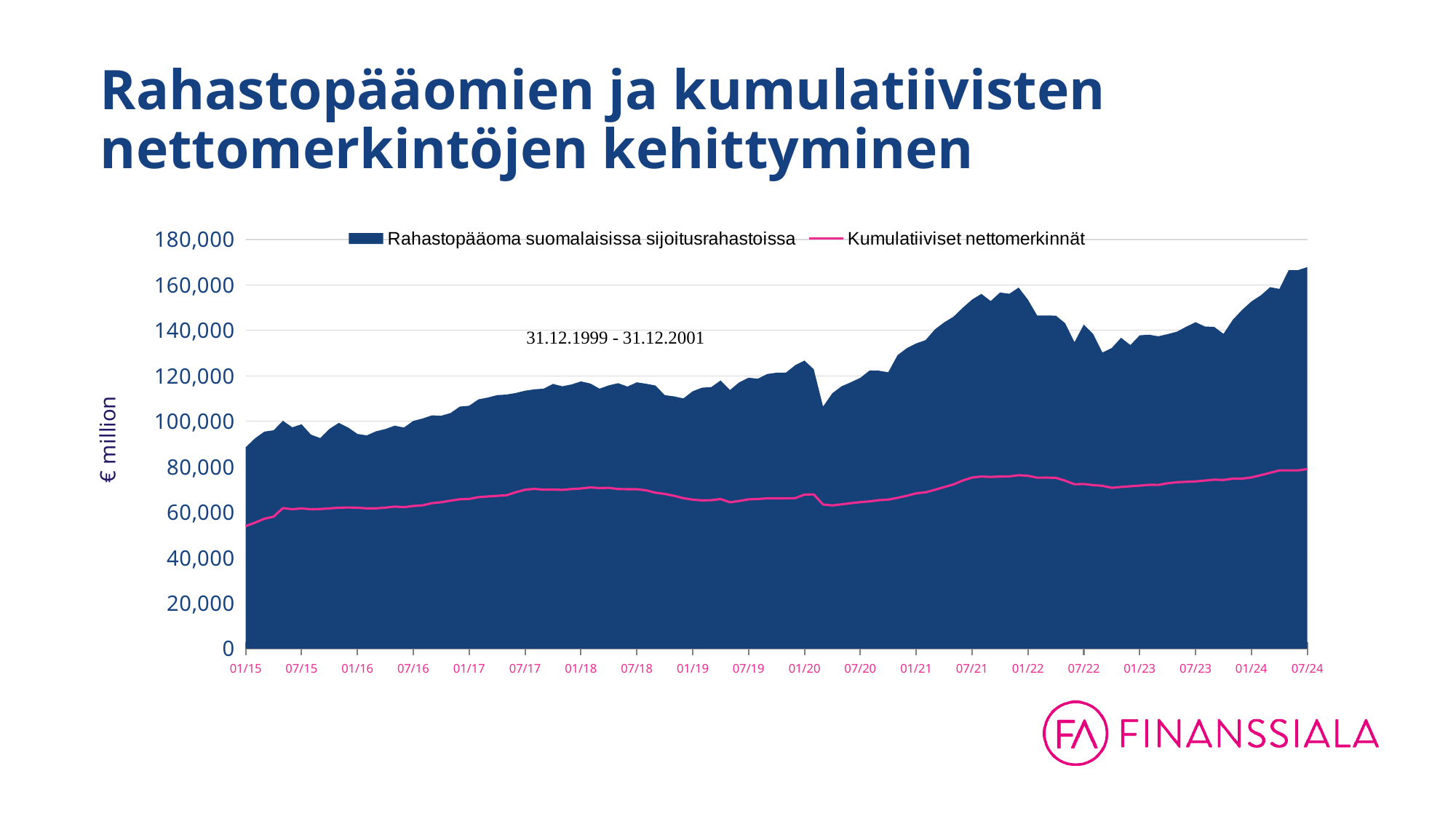
Is the value of Kumulatiiviset nettomerkinnät at 01/15 greater or less than 60,000? less What is the label on the vertical axis? € million At 07/24, which series has the higher value, Rahastopääoma suomalaisissa sijoitusrahastoissa or Kumulatiiviset nettomerkinnät? Rahastopääoma suomalaisissa sijoitusrahastoissa Is the value of Rahastopääoma suomalaisissa sijoitusrahastoissa at 07/21 greater or less than 140,000? greater Overall, does Kumulatiiviset nettomerkinnät rise or fall from 01/15 to 07/24? rise Is the value of Kumulatiiviset nettomerkinnät at 07/24 greater or less than 60,000? greater What are the two series named in the legend? Rahastopääoma suomalaisissa sijoitusrahastoissa; Kumulatiiviset nettomerkinnät How many series does the legend list? 2 What is the highest value shown on the vertical axis? 180,000 What kind of chart is used for the Rahastopääoma suomalaisissa sijoitusrahastoissa series? area chart